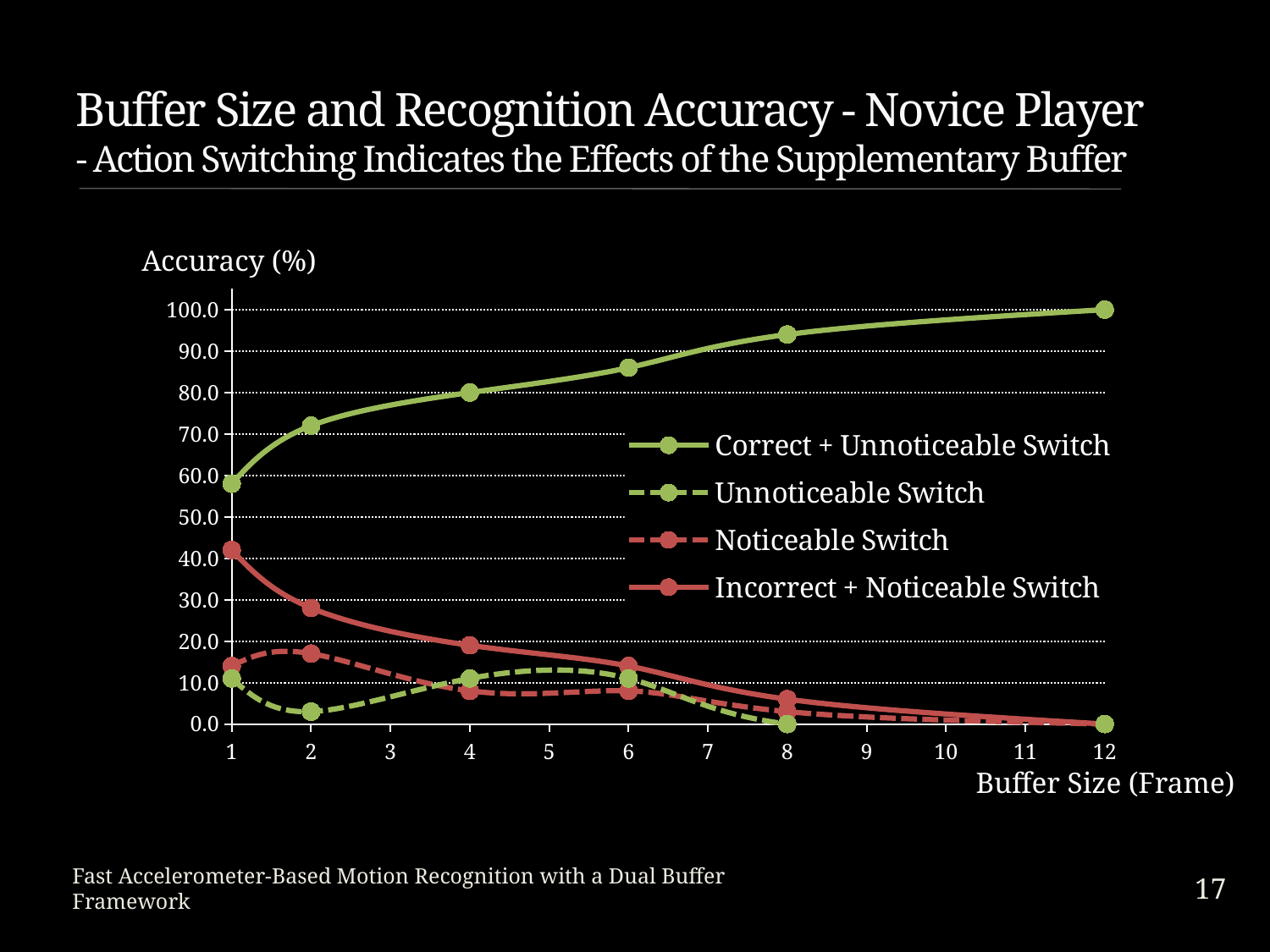
Is the value for Correct + Unnoticeable Switch at buffer size 1 greater or less than 50.0? greater Is the value for Incorrect + Noticeable Switch at buffer size 1 greater or less than 50.0? less How many series does the legend list? 4 At buffer size 2, which is larger: Correct + Unnoticeable Switch or Incorrect + Noticeable Switch? Correct + Unnoticeable Switch How many data points are plotted for the Correct + Unnoticeable Switch series? 6 What kind of chart is shown on the slide? line chart Does the Incorrect + Noticeable Switch series rise or fall as buffer size increases? fall What is the value for Incorrect + Noticeable Switch at buffer size 12? 0.0 What is the label of the x axis? Buffer Size (Frame) What is the accuracy for Correct + Unnoticeable Switch at buffer size 12? 100.0 Does the Correct + Unnoticeable Switch series rise or fall as buffer size increases? rise At which buffer size is the Correct + Unnoticeable Switch series highest? 12